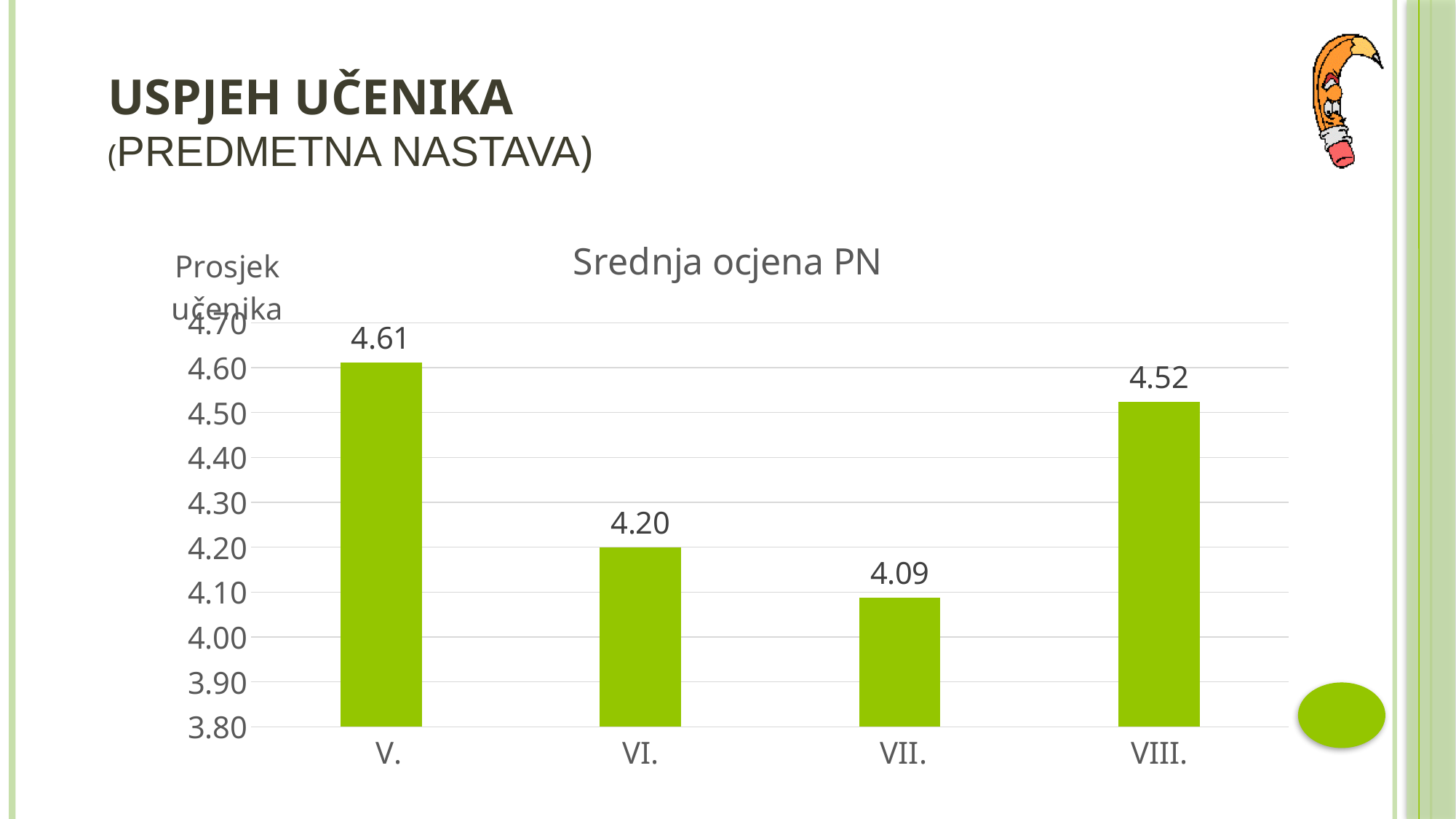
Which category has the highest value? V. What is the title of the chart? Srednja ocjena PN How many categories are shown on the x axis? 4 Is the value for VII. greater or less than 4.20? less Which is larger, the value for VI. or the value for VIII.? VIII. What is the value for V.? 4.61 What is the difference between the values for VIII. and VI.? 0.32 What is the value for VII.? 4.09 What is the difference between the values for V. and VII.? 0.52 What is the value for VI.? 4.20 Which category has the lowest value? VII. What is the value for VIII.? 4.52